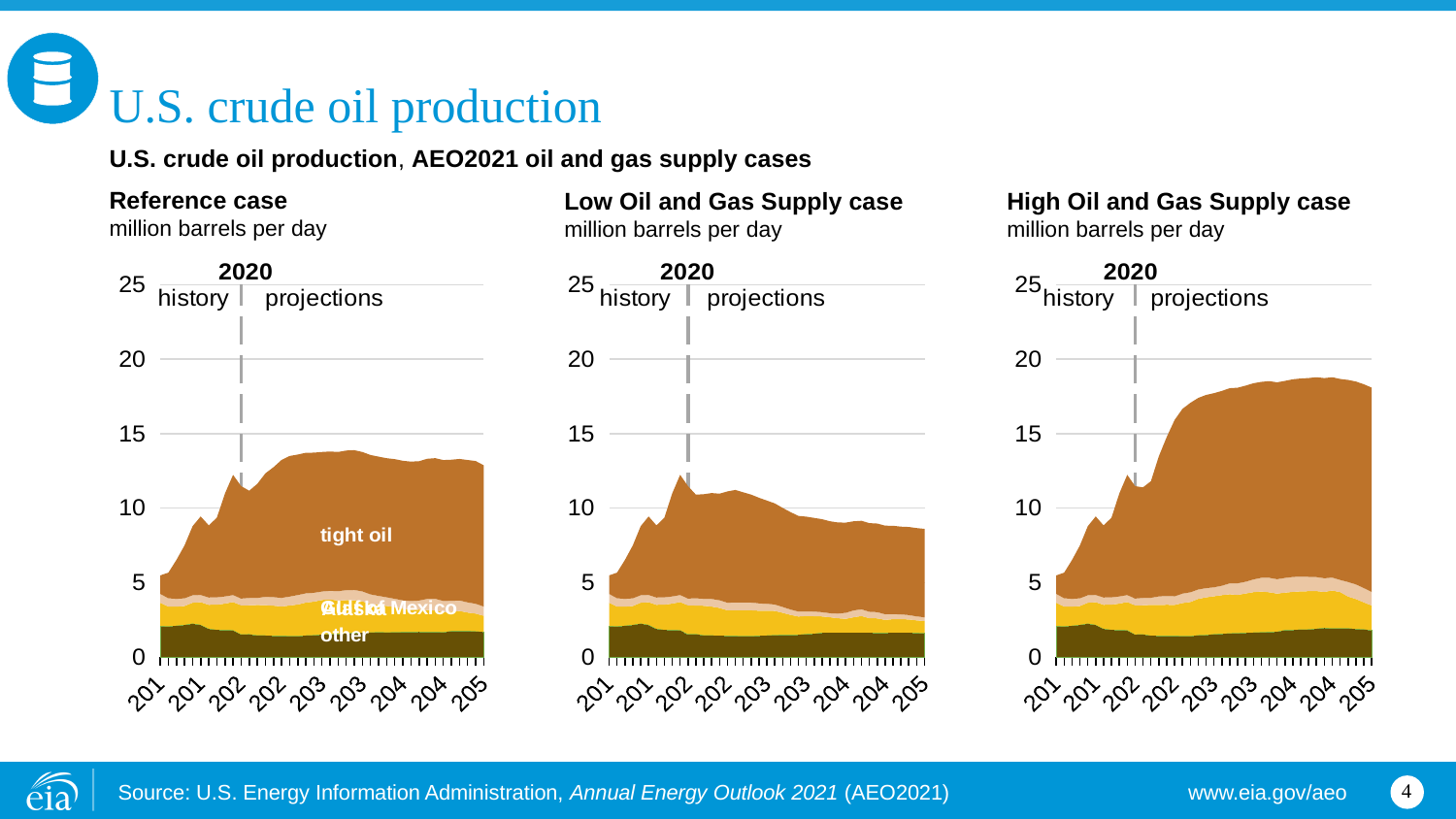
How many charts are shown on the slide? 3 In the High Oil and Gas Supply case chart, is the total production at the end of the projection period greater or less than 15? greater What year does the dashed vertical line separating history from projections mark in each chart? 2020 What kind of chart is used in the Reference case panel? area chart In the Reference case chart, is the total production at the end of the projection period greater or less than 10? greater In the Low Oil and Gas Supply case chart, does total production rise or fall over the projection period after 2020? fall Which series makes up the largest share of production in the Reference case chart? tight oil In the High Oil and Gas Supply case chart, is the peak total production greater or less than 20? less Which chart shows the higher total production at the end of the projection period, the Reference case or the Low Oil and Gas Supply case? Reference case What unit is used on the y axis of all three charts? million barrels per day Which chart shows the higher total production at the end of the projection period, the Low Oil and Gas Supply case or the High Oil and Gas Supply case? High Oil and Gas Supply case